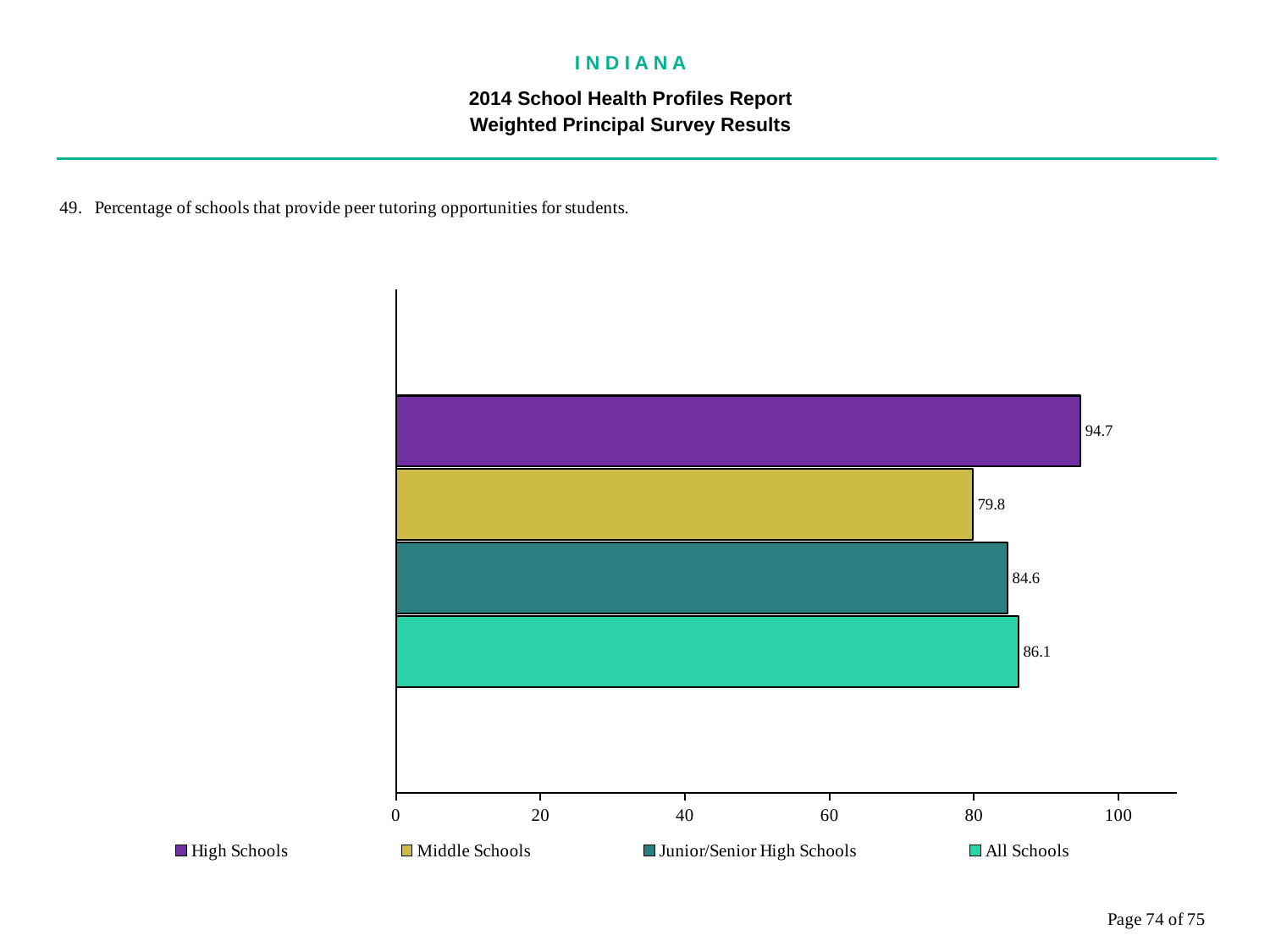
How many series does the legend list? 4 Which school type has the lowest percentage of schools providing peer tutoring opportunities? Middle Schools What is the value for Middle Schools? 79.8 Which school type has the highest percentage of schools providing peer tutoring opportunities? High Schools What is the difference between the values for High Schools and Middle Schools? 14.9 What is the value for Junior/Senior High Schools? 84.6 Which is larger, the value for Junior/Senior High Schools or the value for Middle Schools? Junior/Senior High Schools Is the value for Middle Schools greater or less than 80? less What is the value for High Schools? 94.7 What is the difference between the values for All Schools and Junior/Senior High Schools? 1.5 What is the value for All Schools? 86.1 What kind of chart is shown on the slide? bar chart